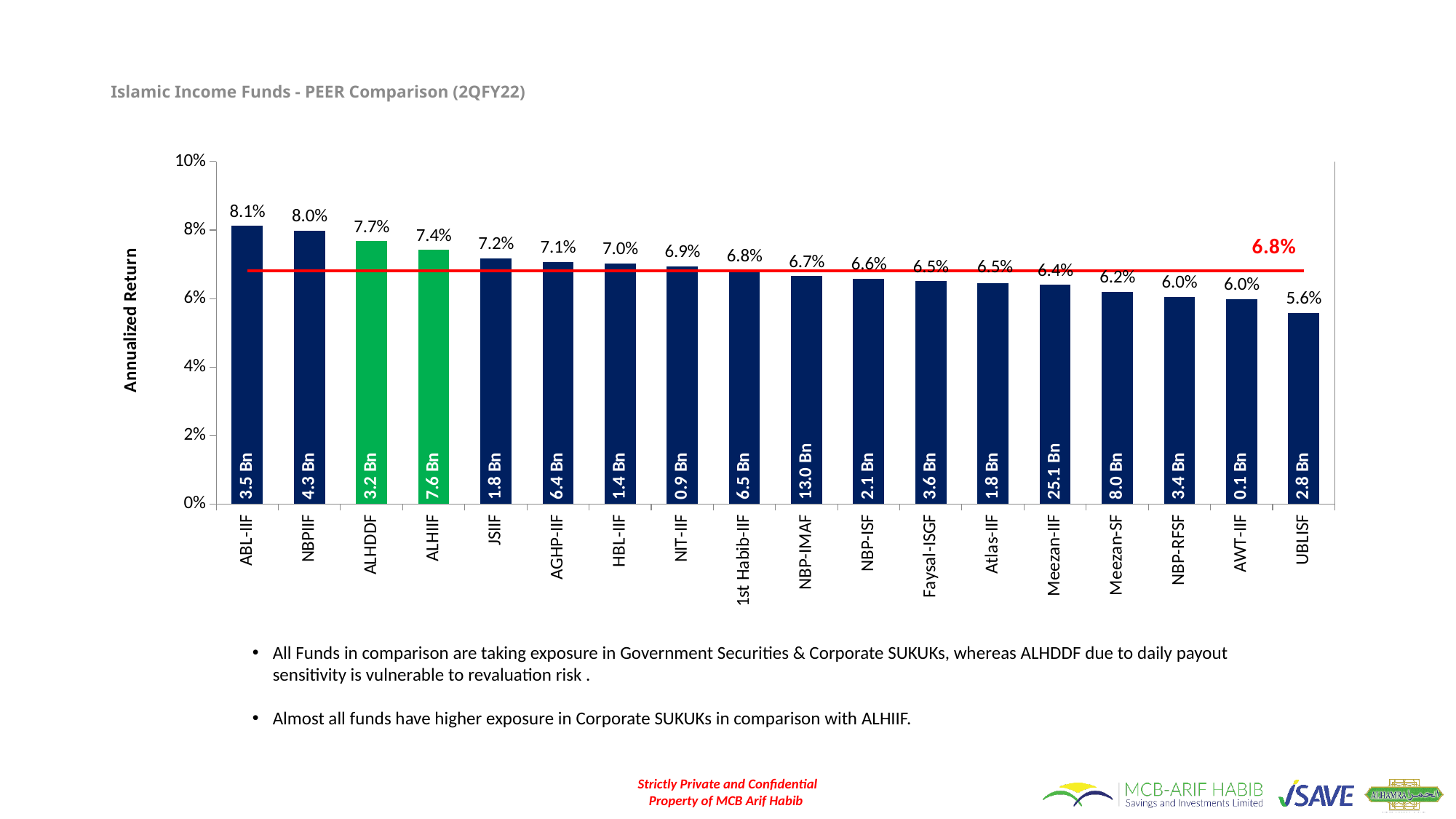
What is the annualized return shown for ALHIIF? 7.4% What fund size (in Bn) is printed on the ALHDDF bar? 3.2 Bn Which has a higher annualized return, ALHDDF or NBP-IMAF? ALHDDF What is the annualized return shown for ABL-IIF? 8.1% What is the difference in annualized return between ABL-IIF and UBLISF? 2.5% What value is labelled on the red horizontal line across the chart? 6.8% Which fund has the highest annualized return? ABL-IIF Which fund has the lowest annualized return? UBLISF Do the annualized returns rise or fall moving from left to right along the x axis? Fall What type of chart is used on this slide? Bar chart What fund size (in Bn) is printed on the Meezan-IIF bar? 25.1 Bn How many funds are shown on the chart? 18